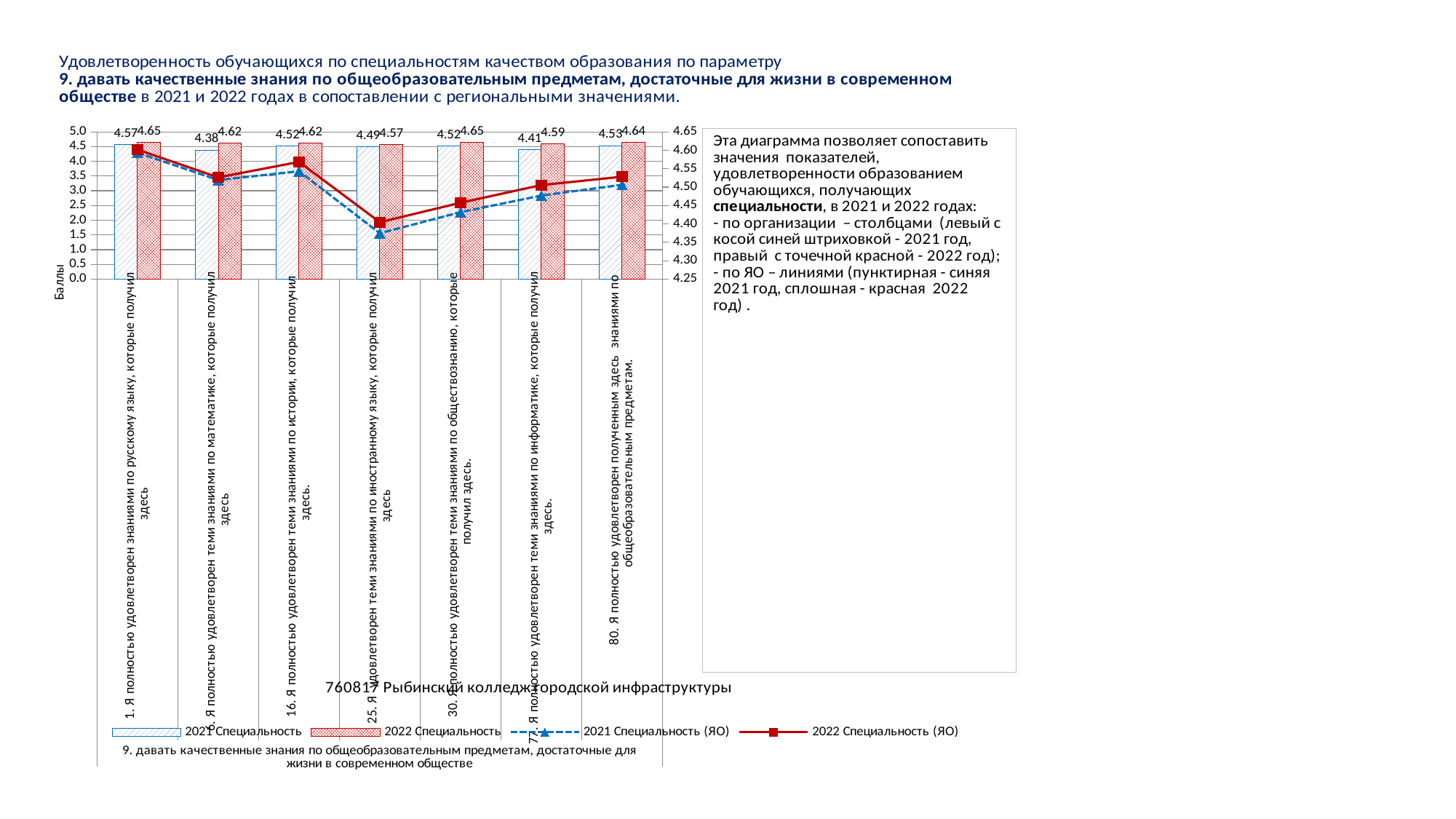
What is the value of the 2022 Специальность bar for category 77 (информатика)? 4.59 How many series does the legend list? 4 Which category has the lowest 2021 Специальность bar? математика (4.38) How many categories are shown on the x axis? 7 What is the value of the 2022 Специальность bar for category 9 (математика)? 4.62 What kind of chart is this? Combined bar and line chart Which is larger: the 2021 Специальность value for история (category 16) or for иностранный язык (category 25)? история (4.52) What is the value of the 2021 Специальность bar for category 1 (русский язык)? 4.57 Which category has the lowest 2022 Специальность bar? 25. иностранный язык (4.57) Is the 2021 Специальность (ЯО) line value for category 25 (иностранный язык) greater or less than 4.45 on the right axis? less What is the difference between the 2022 and 2021 Специальность values for category 77 (информатика)? 0.18 What is the difference between the 2022 and 2021 Специальность values for category 1 (русский язык)? 0.08